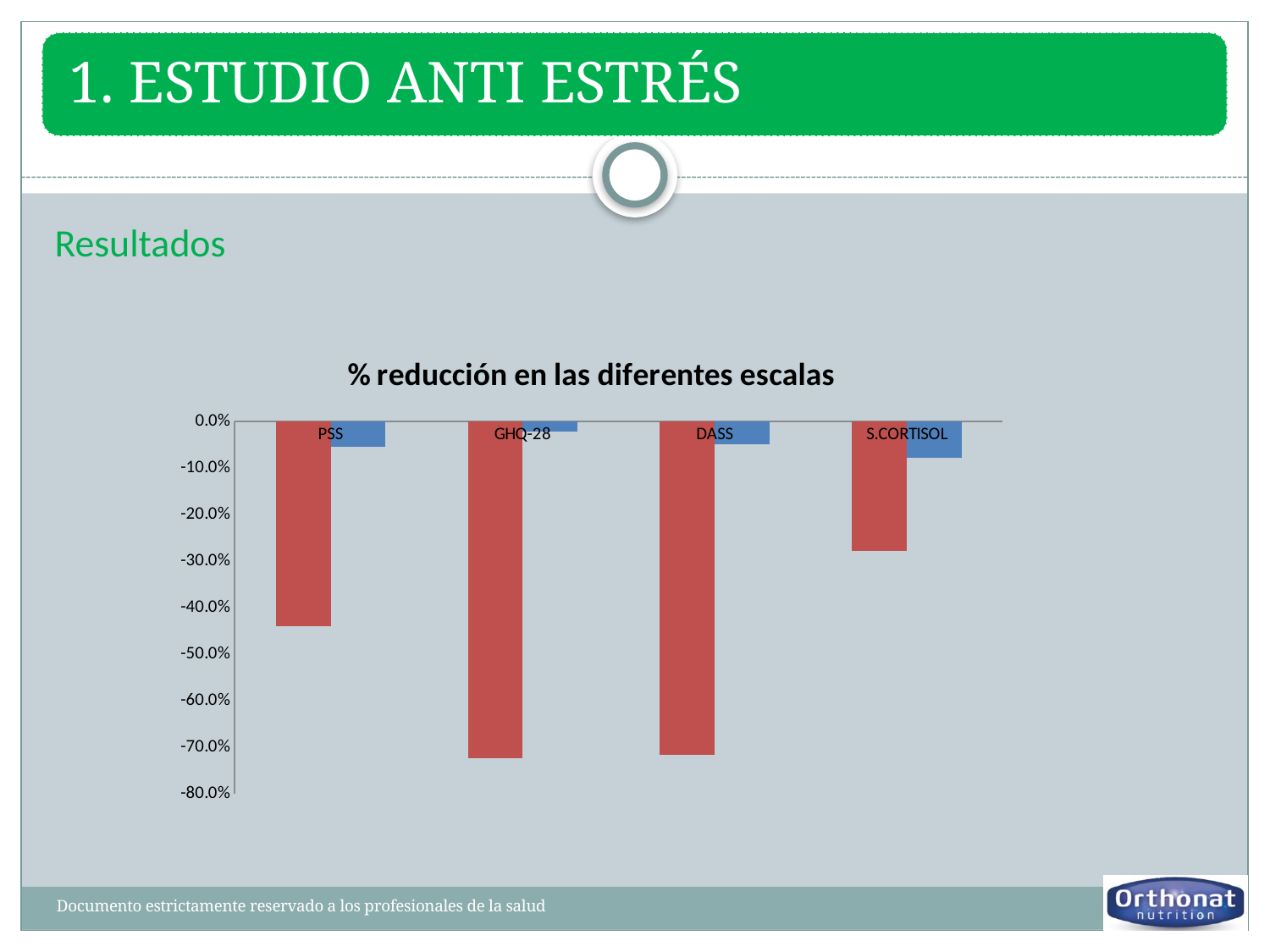
What two colours are used for the bars in the chart? red and blue Does the red bar for S.CORTISOL extend below -30.0% on the axis? no What kind of chart is shown on the slide? bar chart How many categories are shown on the x axis of the chart? 4 What is the title of the chart? % reducción en las diferentes escalas Does the red bar for PSS extend below -40.0% on the axis? yes Does the red bar for GHQ-28 extend below -70.0% on the axis? yes Which red bar extends further below zero, GHQ-28 or S.CORTISOL? GHQ-28 Which blue bar extends further below zero, GHQ-28 or S.CORTISOL? S.CORTISOL Which red bar extends further below zero, PSS or S.CORTISOL? PSS Which category has the red bar that extends the least far below zero (the smallest reduction)? S.CORTISOL